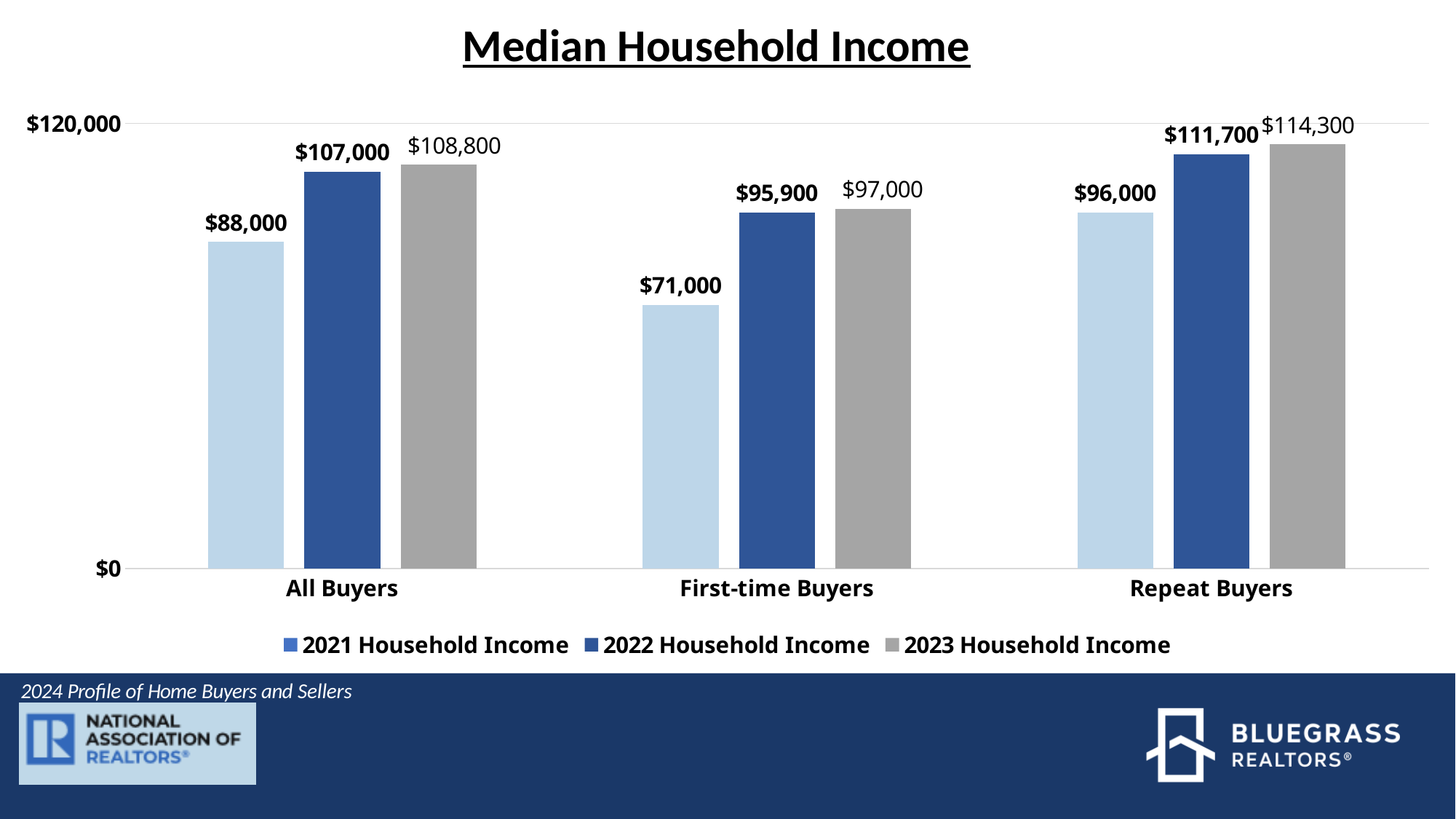
Which buyer category has the highest 2023 Household Income? Repeat Buyers What is the title of the chart? Median Household Income What is the 2022 Household Income for All Buyers? $107,000 What kind of chart is shown on the slide? Bar chart Which is larger: the 2021 Household Income for Repeat Buyers or the 2022 Household Income for First-time Buyers? 2021 Household Income for Repeat Buyers What is the 2023 Household Income for Repeat Buyers? $114,300 Which buyer category has the lowest 2021 Household Income? First-time Buyers What is the difference between the 2023 Household Income for Repeat Buyers and for All Buyers? $5,500 What is the difference between the 2022 and 2021 Household Income for First-time Buyers? $24,900 What is the 2021 Household Income for First-time Buyers? $71,000 How many buyer categories are shown on the x axis? 3 How many series does the legend list? 3